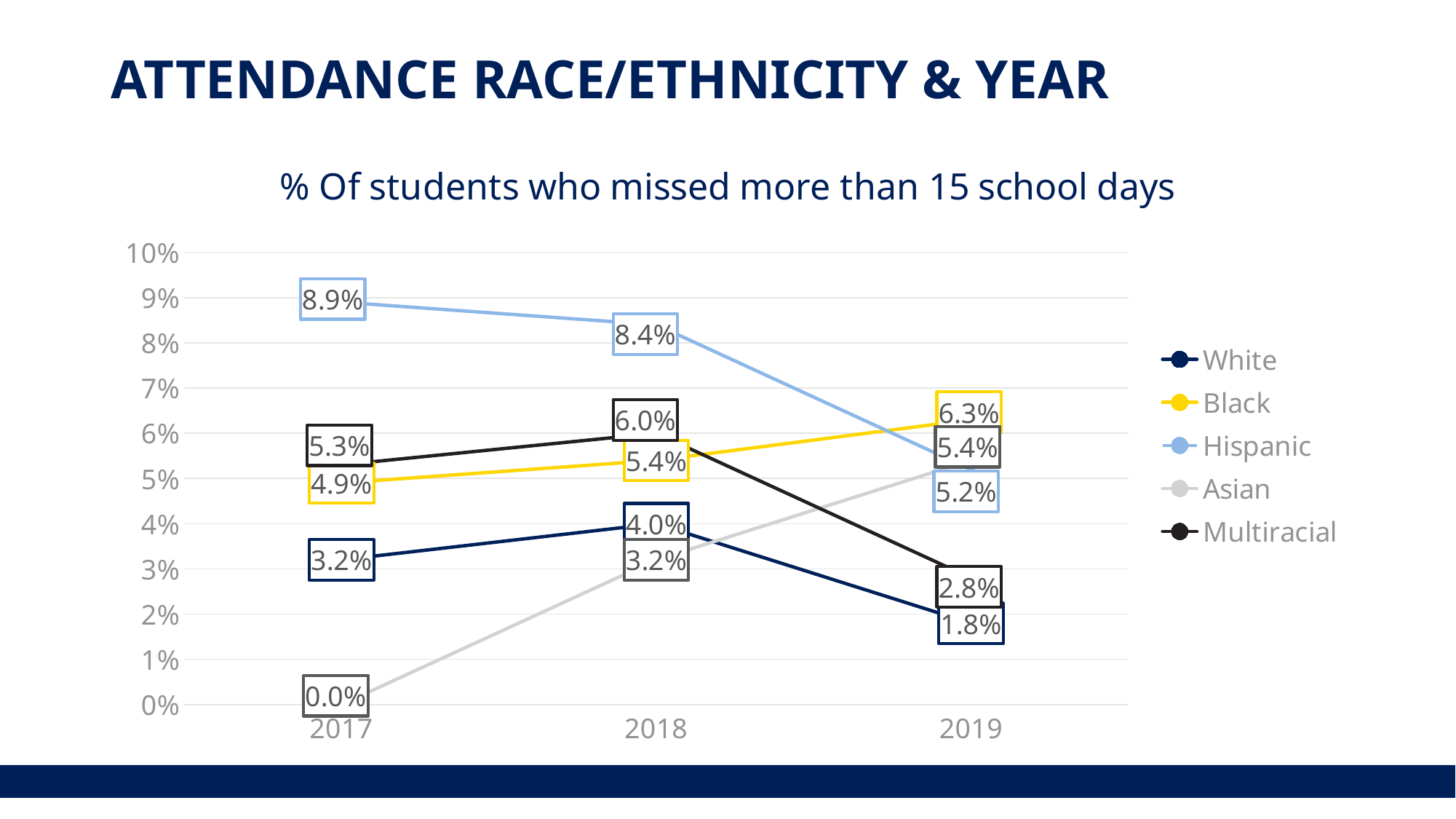
What is the value for Hispanic students in 2017? 8.9% What is the value for Black students in 2019? 6.3% Which group has the lowest value in 2019? White Which group has the highest value in 2017? Hispanic How many series does the legend list? 5 How many years are shown on the x axis? 3 What is the value for Multiracial students in 2018? 6.0% What type of chart is shown on the slide? line chart Which is larger in 2018, the value for White students or the value for Black students? Black Does the value for Black students rise or fall from 2017 to 2019? rise What is the value for Asian students in 2017? 0.0% What is the difference between the Hispanic values in 2018 and 2019? 3.2%